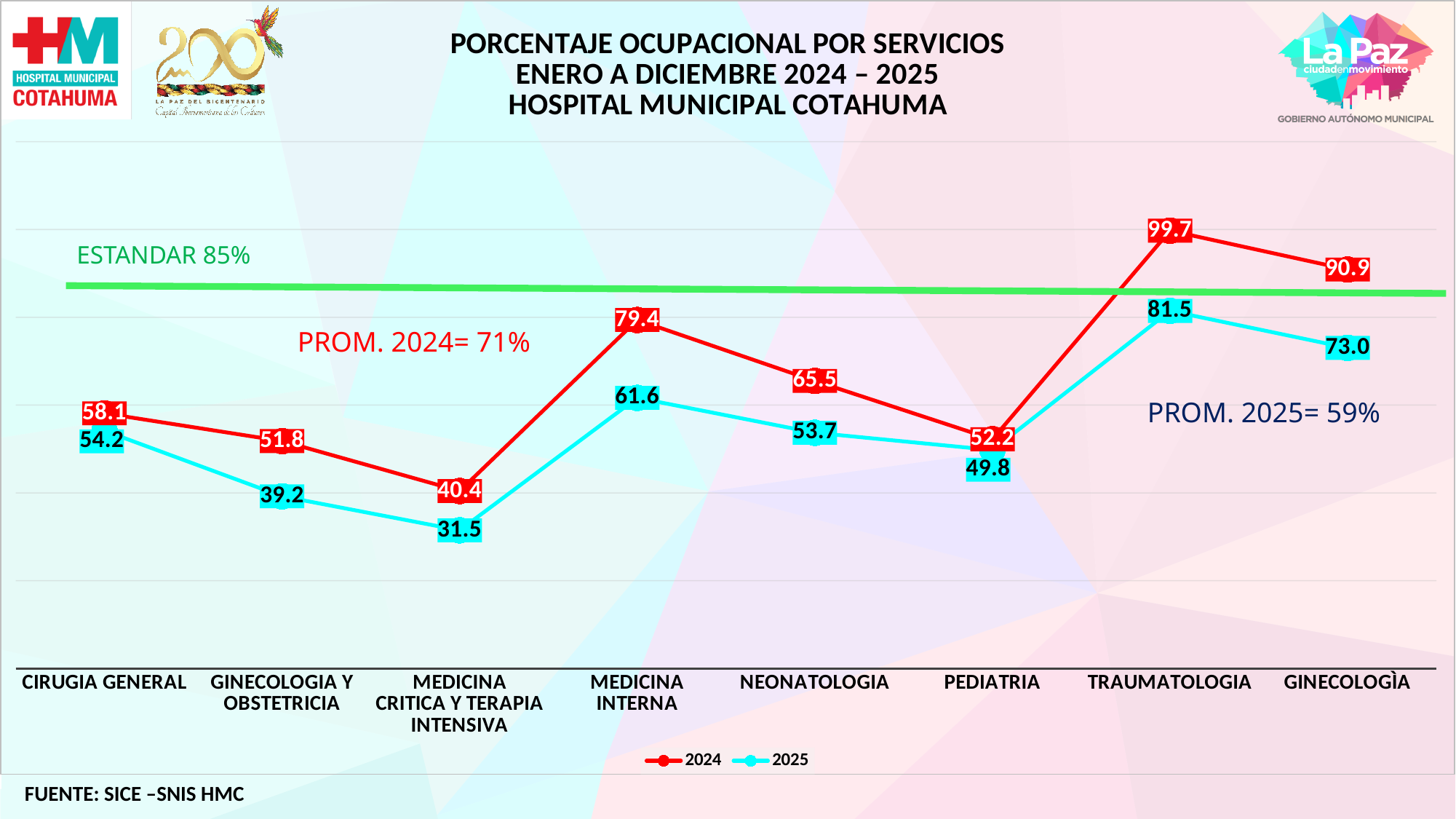
Which service has the lowest 2025 value? MEDICINA CRITICA Y TERAPIA INTENSIVA What type of chart is shown on the slide? line chart How many service categories are plotted along the x axis? 8 Which service has the highest 2024 value? TRAUMATOLOGIA What is the 2025 value for MEDICINA CRITICA Y TERAPIA INTENSIVA? 31.5 What standard percentage is marked by the green horizontal line? 85% How many series does the legend list? 2 What is the difference between the 2024 values for GINECOLOGÌA and CIRUGIA GENERAL? 32.8 What is the 2024 value for MEDICINA INTERNA? 79.4 Which is larger for PEDIATRIA, the 2024 value or the 2025 value? 2024 What is the difference between the 2024 and 2025 values for TRAUMATOLOGIA? 18.2 What is the 2025 value for NEONATOLOGIA? 53.7